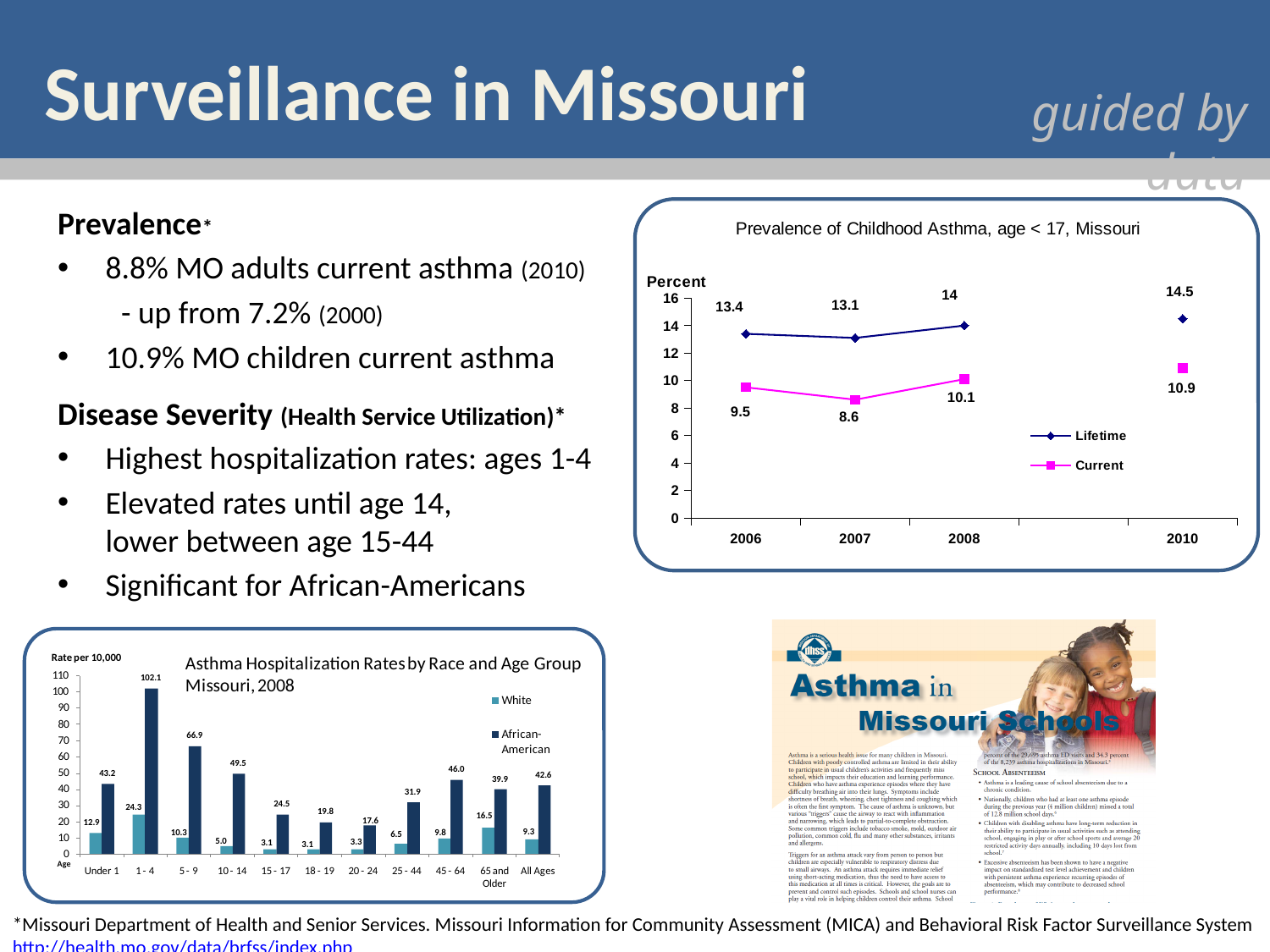
In the 'Asthma Hospitalization Rates by Race and Age Group' chart, how many age group categories are shown on the x axis? 11 What kind of chart is 'Asthma Hospitalization Rates by Race and Age Group Missouri, 2008'? bar chart In the 'Asthma Hospitalization Rates by Race and Age Group' chart, which age group has the highest White rate? 1 - 4 In the 'Asthma Hospitalization Rates by Race and Age Group' chart, what is the African-American rate for ages 1 - 4? 102.1 In the 'Prevalence of Childhood Asthma' chart, what is the Lifetime value for 2010? 14.5 In the 'Prevalence of Childhood Asthma' chart, what is the difference between the Lifetime and Current values in 2008? 3.9 In the 'Asthma Hospitalization Rates by Race and Age Group' chart, which is larger: the African-American rate for 45 - 64 or for 65 and Older? 45 - 64 In the 'Prevalence of Childhood Asthma' chart, does the Current series rise or fall from 2007 to 2010? rise In the 'Asthma Hospitalization Rates by Race and Age Group' chart, what is the difference between the African-American and White rates for All Ages? 33.3 In the 'Prevalence of Childhood Asthma' chart, how many series does the legend list? 2 In the 'Prevalence of Childhood Asthma' chart, which year has the lowest Current value? 2007 In the 'Prevalence of Childhood Asthma' chart, what is the Current value for 2007? 8.6